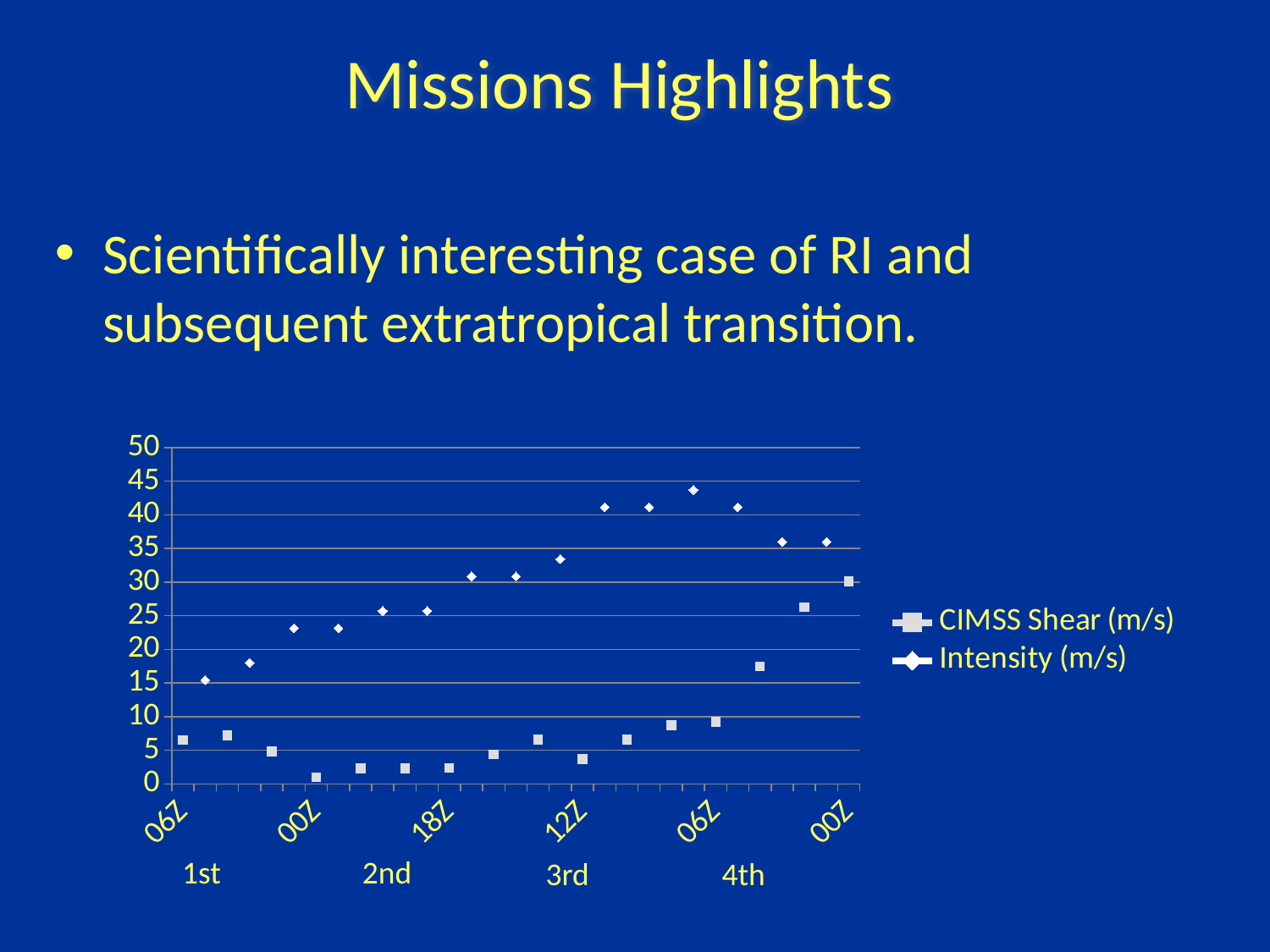
Is the Intensity (m/s) value at 00Z on the 2nd greater or less than 20? greater Is the Intensity (m/s) value at 06Z on the 1st greater or less than 20? less How many series does the chart legend list? 2 Does Intensity (m/s) generally rise or fall from 06Z on the 1st to 06Z on the 4th? rise At 12Z on the 3rd, which series has the larger value, CIMSS Shear (m/s) or Intensity (m/s)? Intensity (m/s) At which x-axis label does Intensity (m/s) reach its highest value? 06Z (4th) Is the Intensity (m/s) value at 12Z on the 3rd greater or less than 30? greater How many time labels are shown along the x axis of the chart? 6 At which x-axis label is CIMSS Shear (m/s) at its lowest value? 00Z (2nd) What are the two series named in the chart legend? CIMSS Shear (m/s) and Intensity (m/s)